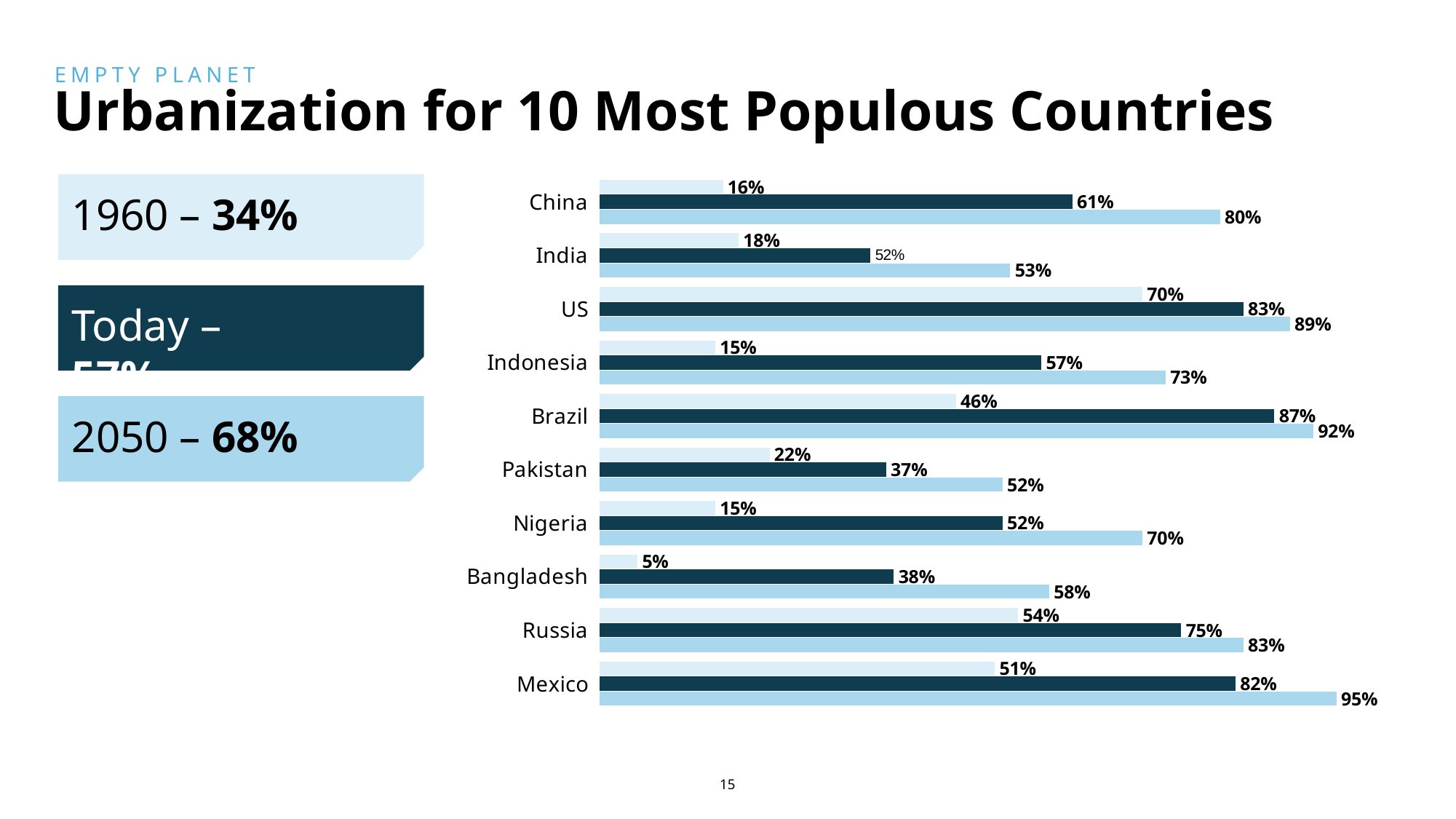
How many countries are listed on the chart? 10 What is the value of the dark (middle) bar for Pakistan? 37% What is the value of the top (lightest) bar for Bangladesh? 5% What is the difference between the bottom bar and the top bar for Indonesia? 58% How many bars are shown for each country? 3 What is the value of the dark (middle) bar for China? 61% Which country has the lowest value on its top (lightest) bar? Bangladesh Which country has the highest value on its bottom (medium blue) bar? Mexico What is the value of the bottom (medium blue) bar for Mexico? 95% Which is larger: the dark (middle) bar for Brazil or the dark (middle) bar for Russia? Brazil What type of chart is shown on the slide? bar chart What is the title of the chart slide? Urbanization for 10 Most Populous Countries